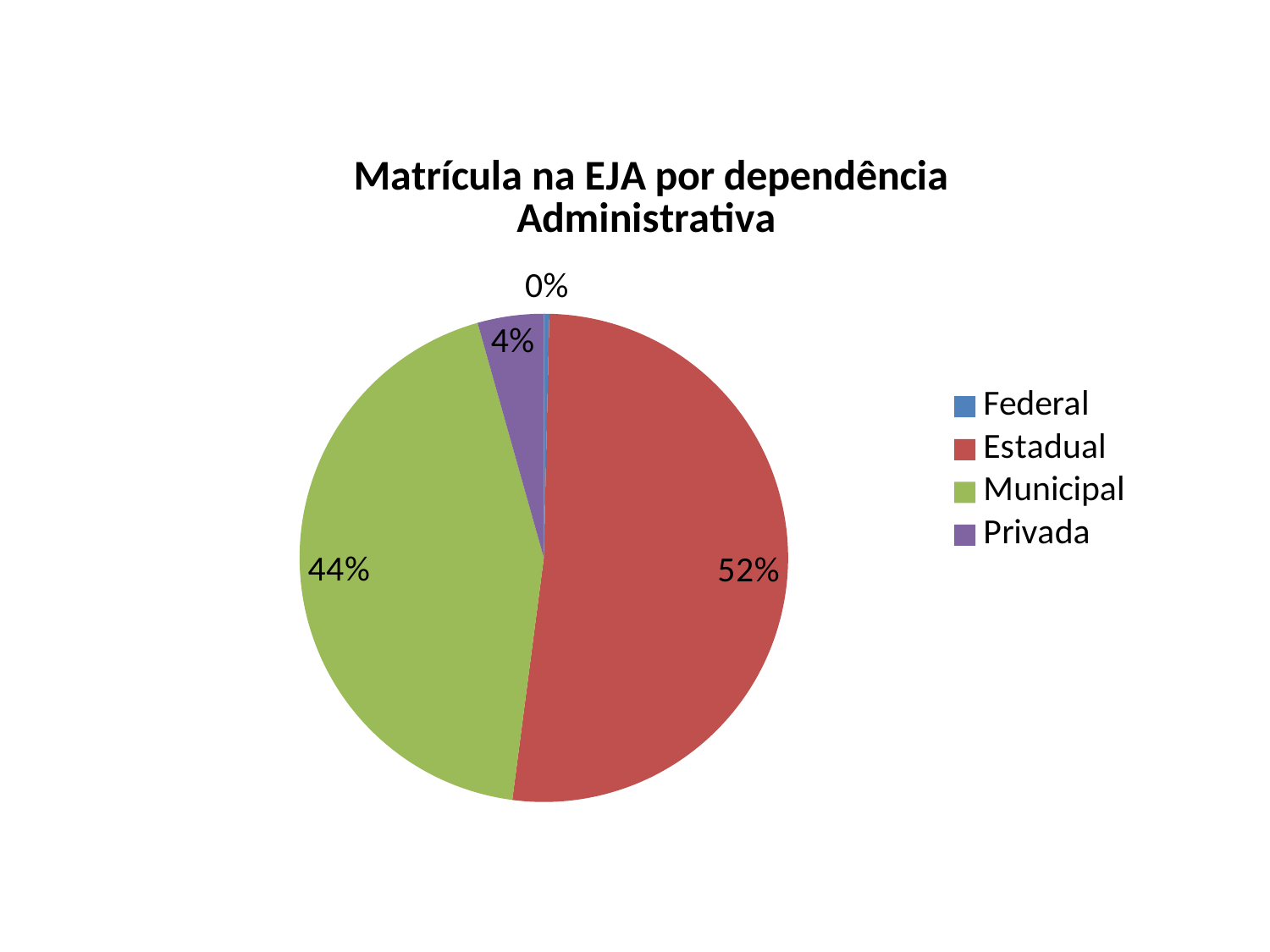
What colour is the Municipal slice? green Which is larger, the Municipal share or the Privada share? Municipal How many categories does the legend list? 4 What is the title of the chart? Matrícula na EJA por dependência Administrativa What share of the pie does Federal represent? 0% What is the difference in percentage points between the Estadual and Municipal shares? 8% What share of the pie does Municipal represent? 44% Which category has the largest share of the pie? Estadual What share of the pie does Estadual represent? 52% What type of chart is shown on the slide? pie chart Which category has the smallest share of the pie? Federal